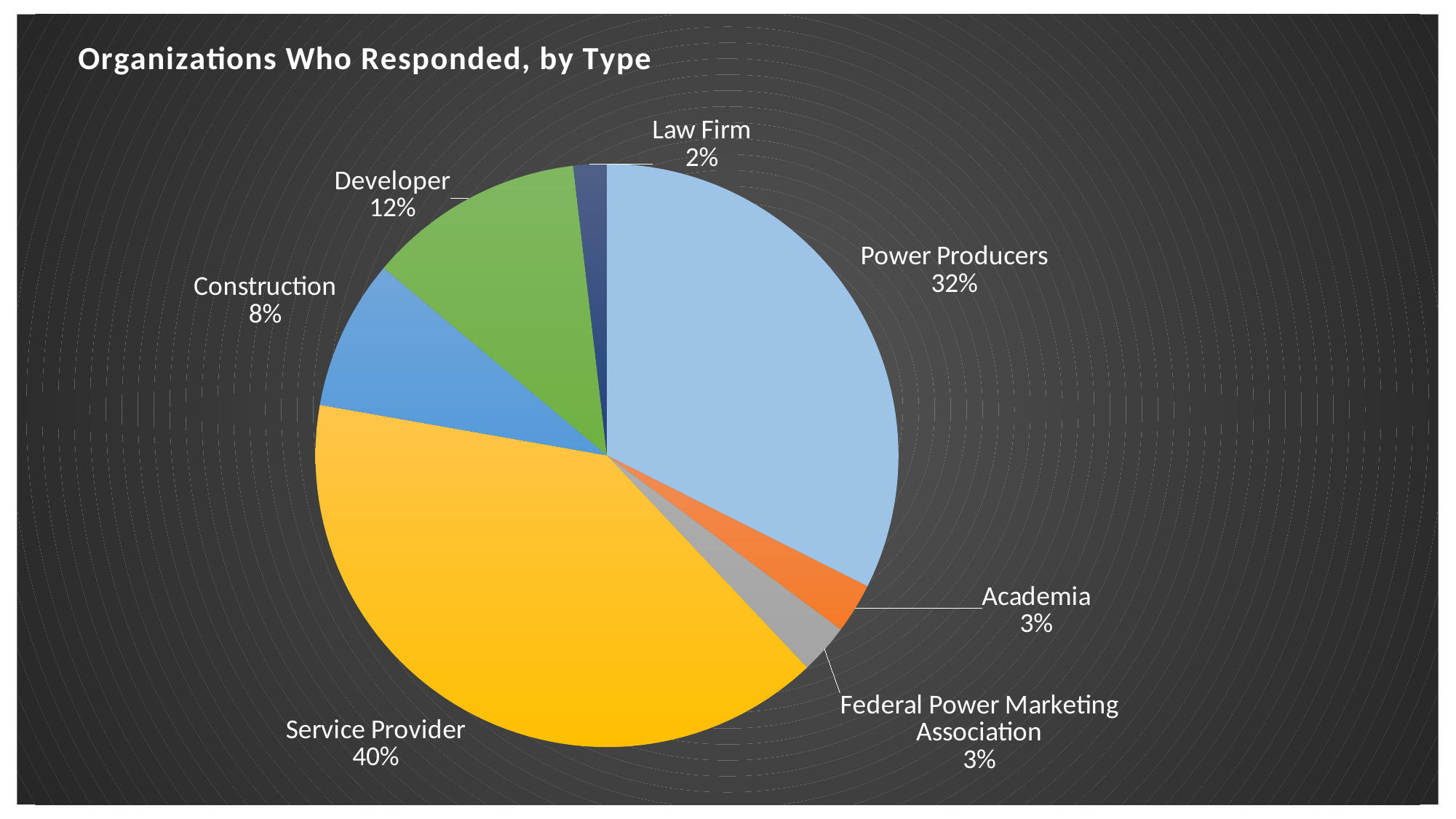
What percentage is shown for Construction? 8% What percentage is shown for Developer? 12% Which is larger, Developer or Construction? Developer Which organization type has the largest slice? Service Provider What share of the pie is Power Producers? 32% What percentage is shown for Law Firm? 2% What share of the pie is Service Provider? 40% What kind of chart is shown on the slide? pie chart Which organization type has the smallest slice? Law Firm What is the difference in percentage points between Service Provider and Power Producers? 8 What is the title of the chart? Organizations Who Responded, by Type How many organization types are shown in the pie chart? 7